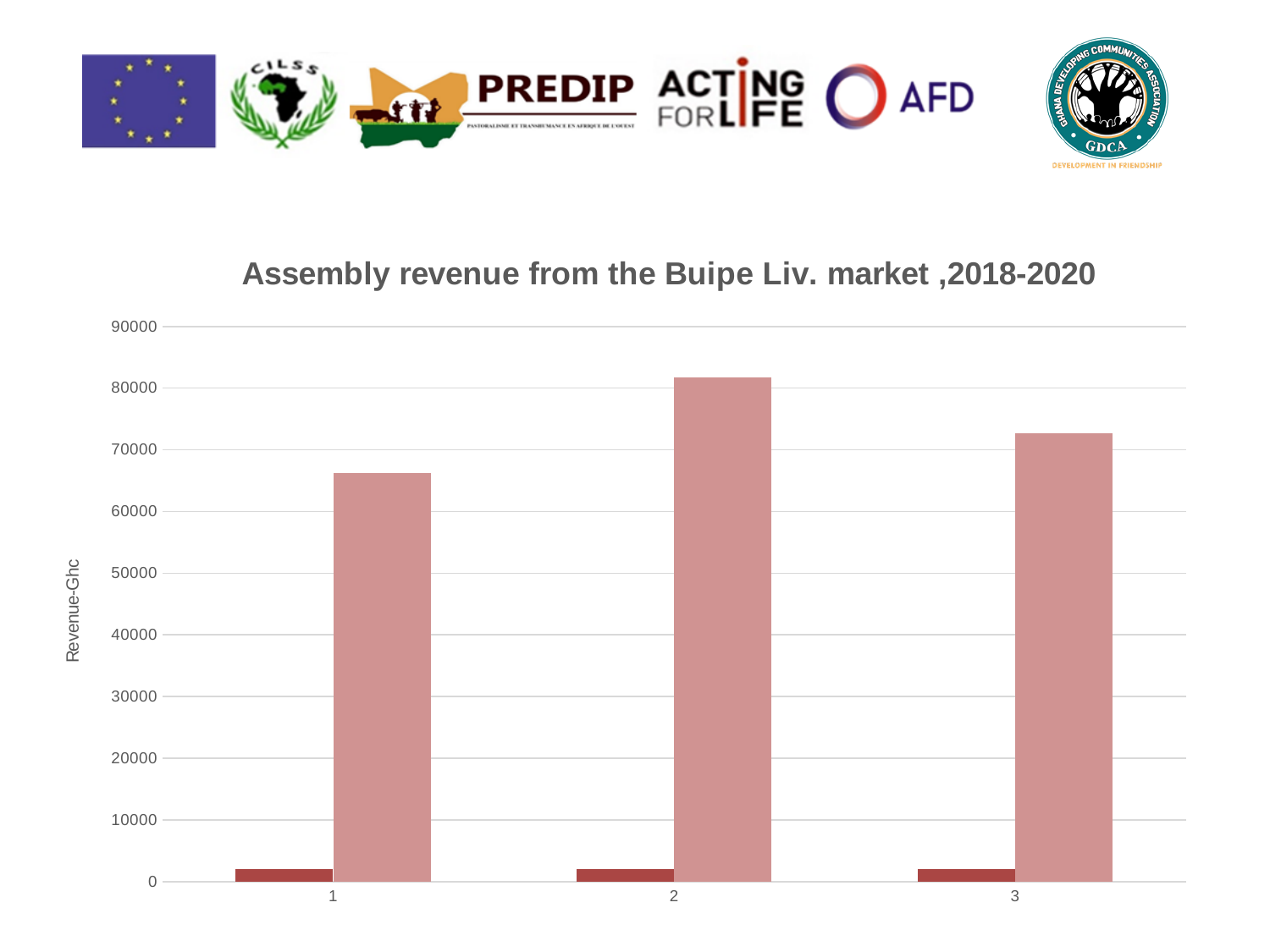
Is the value of the dark red bar for category 1 greater or less than 10000? less Which is larger, the pink bar for category 2 or the pink bar for category 3? category 2 What is the title of the chart? Assembly revenue from the Buipe Liv. market ,2018-2020 How many categories are shown along the x axis? 3 Which category has the tallest pink bar? 2 How many bars are plotted for each category on the x axis? 2 Which category has the shortest pink bar? 1 Is the value of the pink bar for category 2 greater or less than 80000? greater Is the value of the pink bar for category 3 greater or less than 70000? greater What kind of chart is shown on the slide? bar chart What is the label on the vertical axis of the chart? Revenue-Ghc